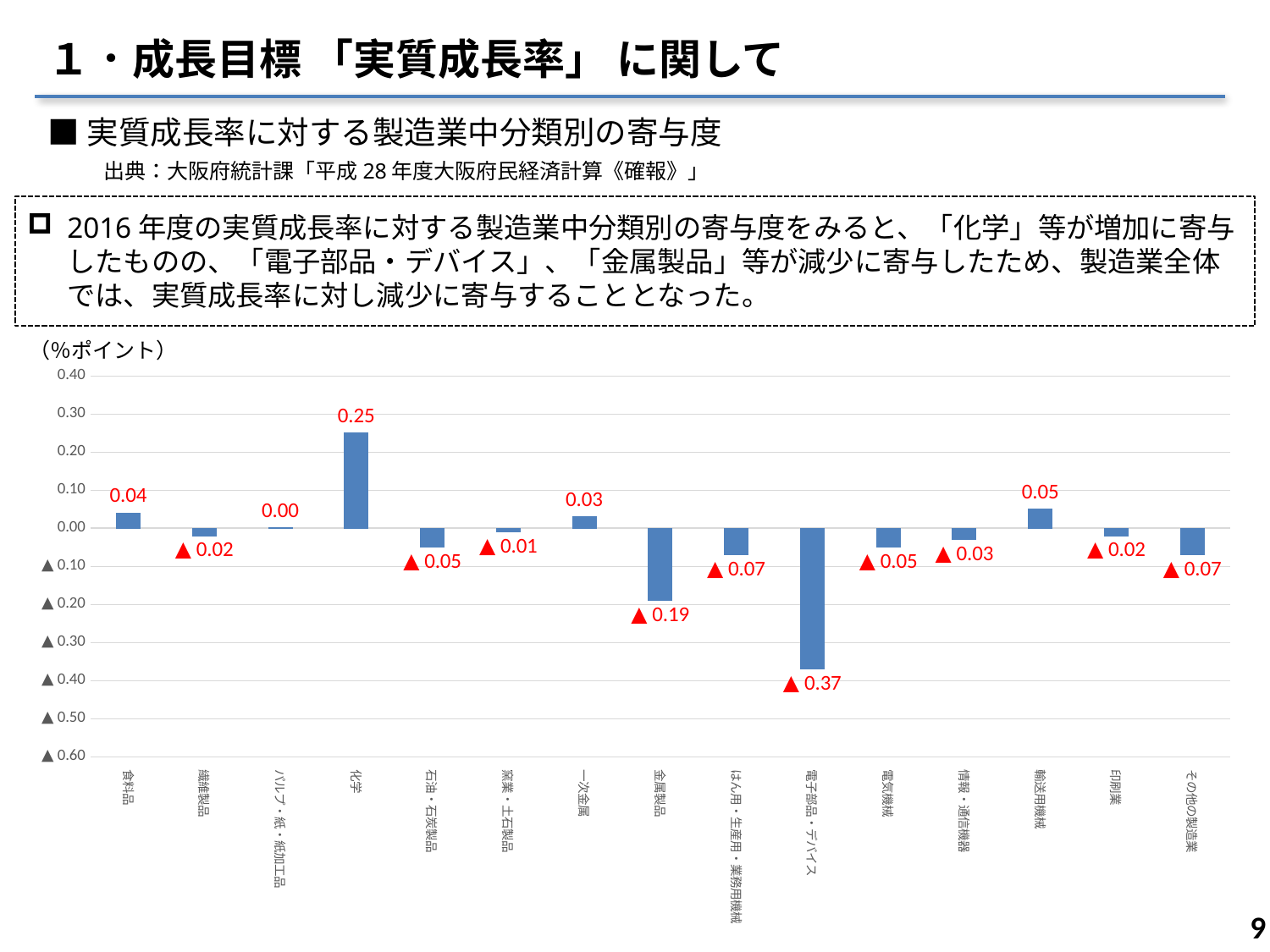
What is the value for 電子部品・デバイス? ▲ 0.37 Which category has the lowest value? 電子部品・デバイス Which category has the highest value? 化学 What is the value for 化学? 0.25 How many categories are shown on the x axis? 15 What is the difference between the values for 化学 and 食料品? 0.21 What is the value for 金属製品? ▲ 0.19 What kind of chart is this? bar chart Which is larger, the value for 食料品 or the value for 一次金属? 食料品 What unit is shown above the chart's vertical axis? %ポイント What is the value for 輸送用機械? 0.05 What is the value for パルプ・紙・紙加工品? 0.00